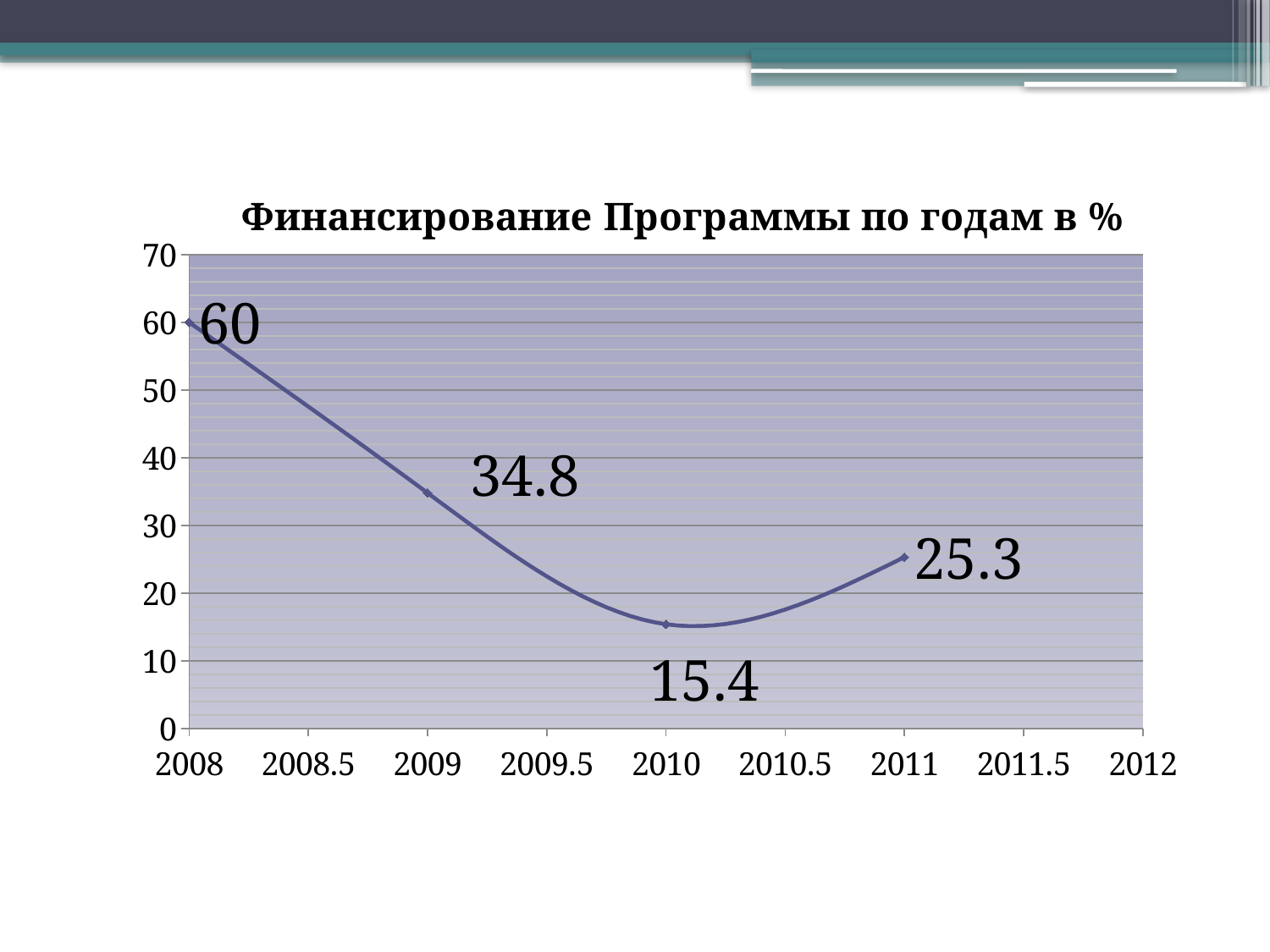
What is the value for 2009? 34.8 How many data points are plotted on the chart? 4 Which year has the lowest value? 2010 What is the value for 2010? 15.4 What is the value for 2008? 60 What kind of chart is shown on the slide? line chart Do the values rise or fall from 2008 to 2010? fall What is the title of the chart? Финансирование Программы по годам в % Which year has the highest value? 2008 What is the value for 2011? 25.3 Which is larger, the value for 2010 or the value for 2011? 2011 What is the difference between the values for 2008 and 2009? 25.2